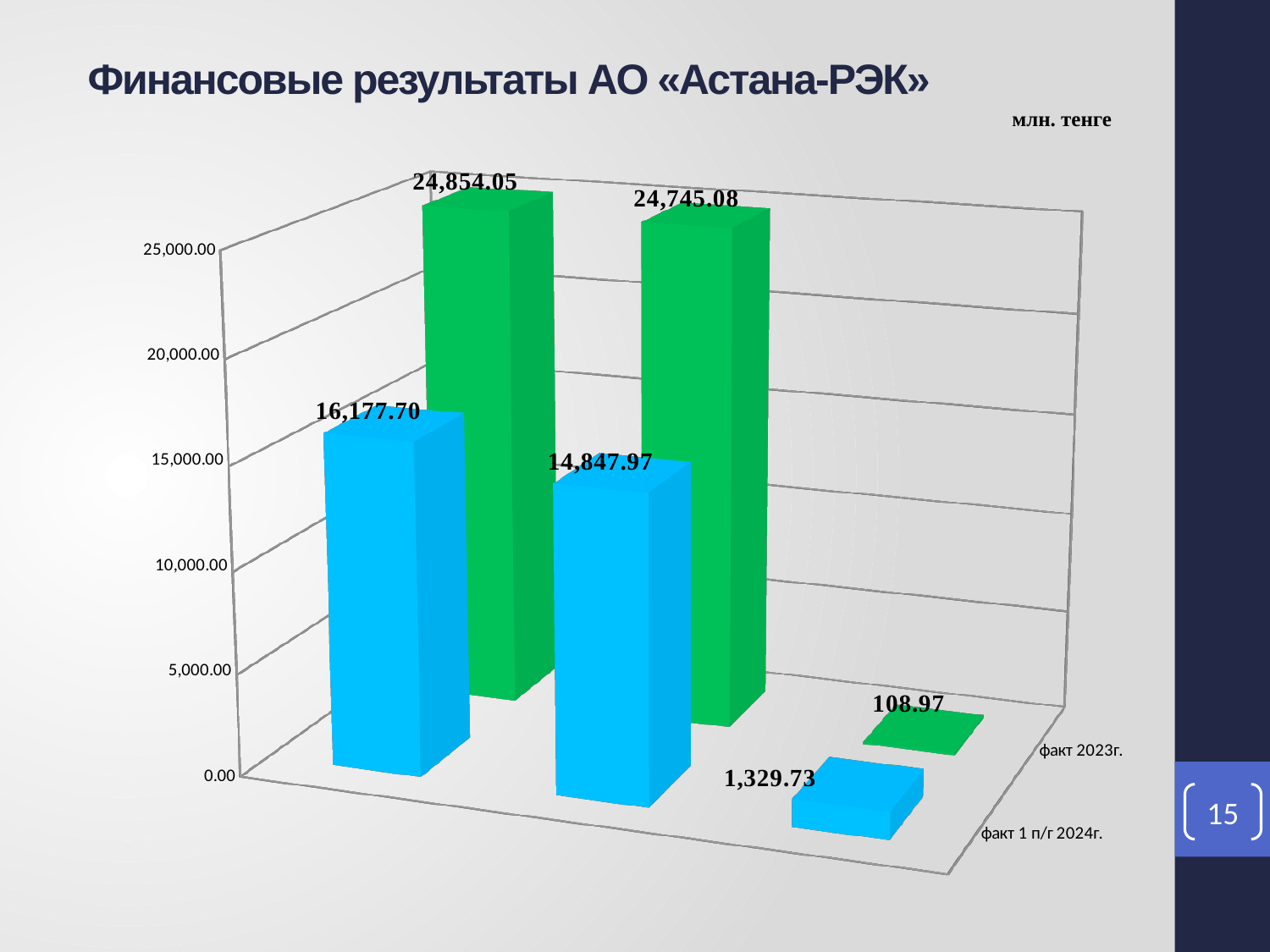
How many groups of bars are plotted in the chart? 3 What is the value of the second bar in the факт 2023г. series? 24,745.08 How many series does the chart show? 2 What is the value of the third (rightmost) bar in the факт 1 п/г 2024г. series? 1,329.73 What is the value of the second bar in the факт 1 п/г 2024г. series? 14,847.97 What kind of chart is shown on the slide? bar chart What unit of measurement is stated above the chart? млн. тенге For the third group of bars, which series has the larger value: факт 2023г. or факт 1 п/г 2024г.? факт 1 п/г 2024г. What is the value of the first (leftmost) bar in the факт 2023г. series? 24,854.05 Which bar in the факт 2023г. series has the lowest value? the third bar (108.97) What is the difference between the first bar of факт 2023г. (24,854.05) and the first bar of факт 1 п/г 2024г. (16,177.70)? 8,676.35 Is the value of the first bar in the факт 1 п/г 2024г. series greater or less than 10,000.00? greater